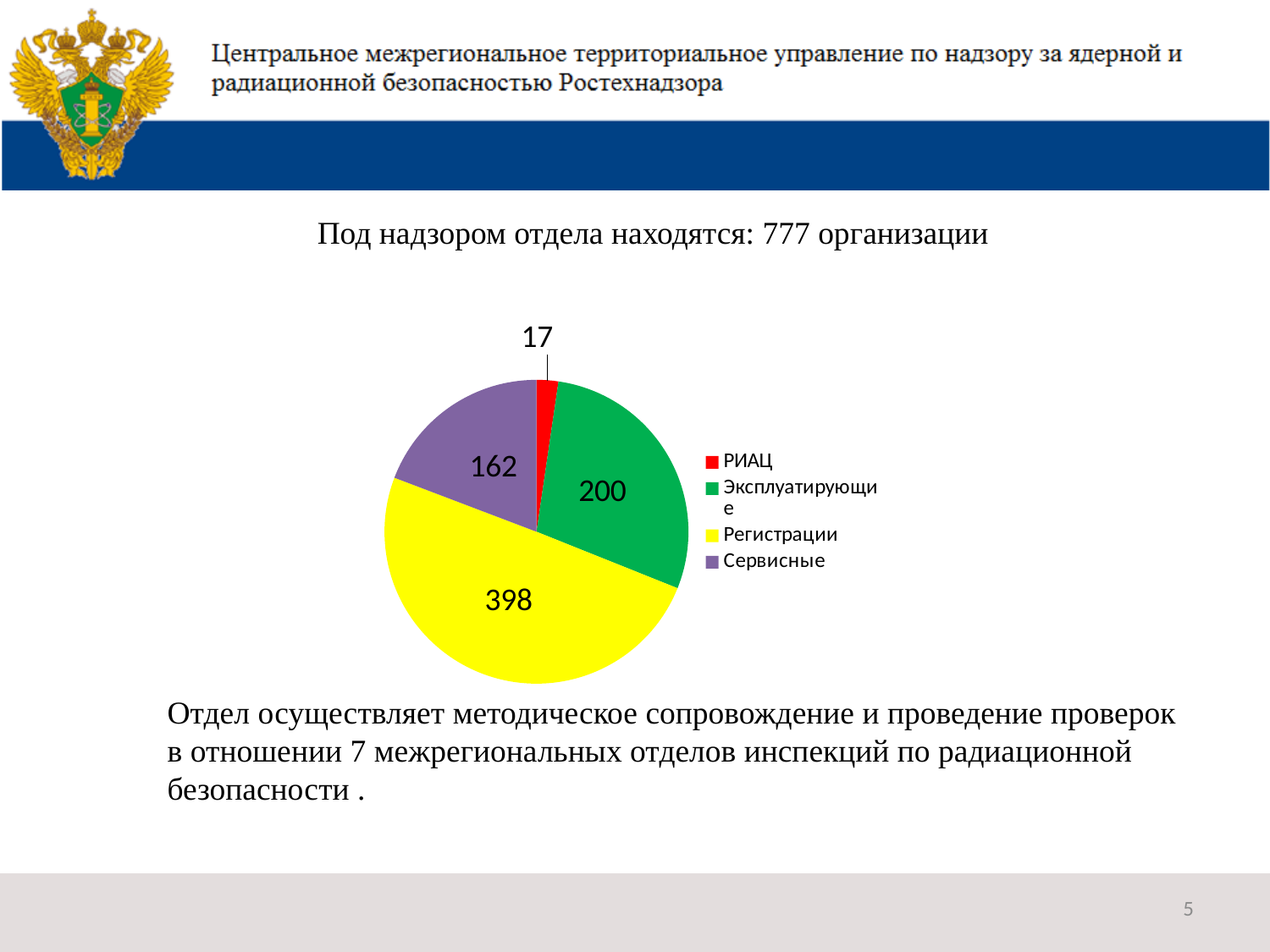
Which category has the largest slice of the pie? Регистрации Which is larger, the Эксплуатирующие slice or the Сервисные slice? Эксплуатирующие Which category has the smallest slice of the pie? РИАЦ What is the value for the Сервисные slice? 162 What is the value for the РИАЦ slice? 17 What is the difference between the Регистрации and Эксплуатирующие values? 198 How many categories does the pie chart have? 4 What is the value for the Эксплуатирующие slice? 200 How many organizations are in the Регистрации category? 398 What colour is the Регистрации slice? yellow What type of chart is shown on the slide? pie chart What is the total of all slices in the pie chart? 777